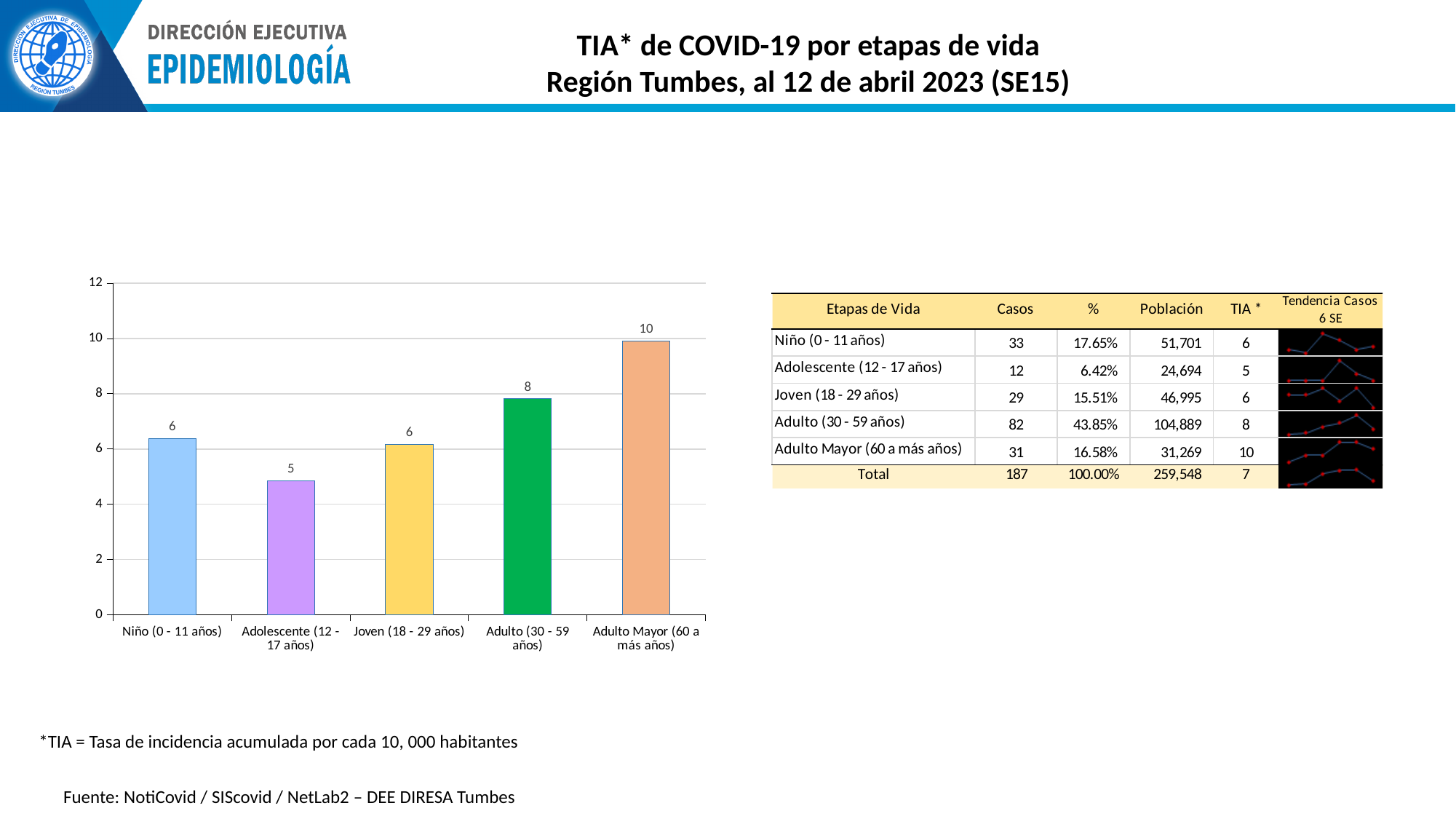
What is the TIA value shown for Adulto Mayor (60 a más años) in the bar chart? 10 What is the TIA value shown for Adolescente (12 - 17 años) in the bar chart? 5 Which life stage has the highest bar in the chart? Adulto Mayor (60 a más años) Is the bar for Adolescente (12 - 17 años) greater or less than 6? less What kind of chart is used to show the TIA by life stage? bar chart What is the difference between the labelled values for Adulto Mayor (60 a más años) and Adolescente (12 - 17 años)? 5 What is the TIA value shown for Niño (0 - 11 años) in the bar chart? 6 What is the TIA value shown for Adulto (30 - 59 años) in the bar chart? 8 What colour is the bar for Adulto (30 - 59 años)? green Which life stage has the lowest bar in the chart? Adolescente (12 - 17 años) How many life-stage categories are plotted in the bar chart? 5 Which has a larger value in the bar chart, Adulto (30 - 59 años) or Joven (18 - 29 años)? Adulto (30 - 59 años)